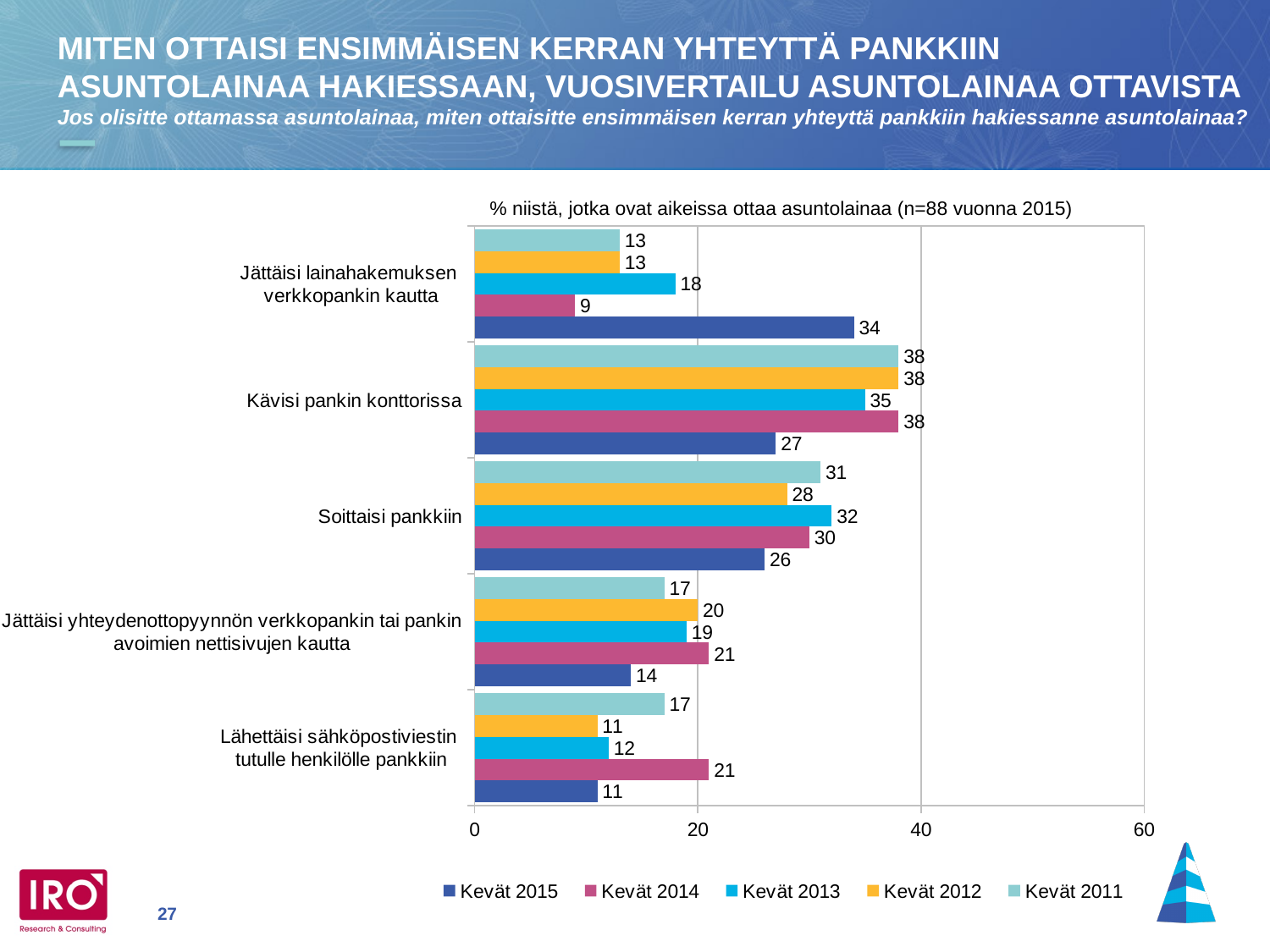
Which category has the lowest Kevät 2014 value? Jättäisi lainahakemuksen verkkopankin kautta What is the Kevät 2014 value for "Jättäisi lainahakemuksen verkkopankin kautta"? 9 What kind of chart is shown on the slide? Bar chart What is the Kevät 2013 value for "Kävisi pankin konttorissa"? 35 How many series does the legend list? 5 What is the Kevät 2015 value for "Jättäisi lainahakemuksen verkkopankin kautta"? 34 For "Kävisi pankin konttorissa", which is larger: the Kevät 2011 value or the Kevät 2015 value? Kevät 2011 What is the Kevät 2012 value for "Soittaisi pankkiin"? 28 What is the difference between the Kevät 2015 and Kevät 2014 values for "Jättäisi lainahakemuksen verkkopankin kautta"? 25 Which category has the highest Kevät 2015 value? Jättäisi lainahakemuksen verkkopankin kautta How many categories are shown on the chart? 5 Is the Kevät 2014 value for "Lähettäisi sähköpostiviestin tutulle henkilölle pankkiin" greater or less than 20? greater